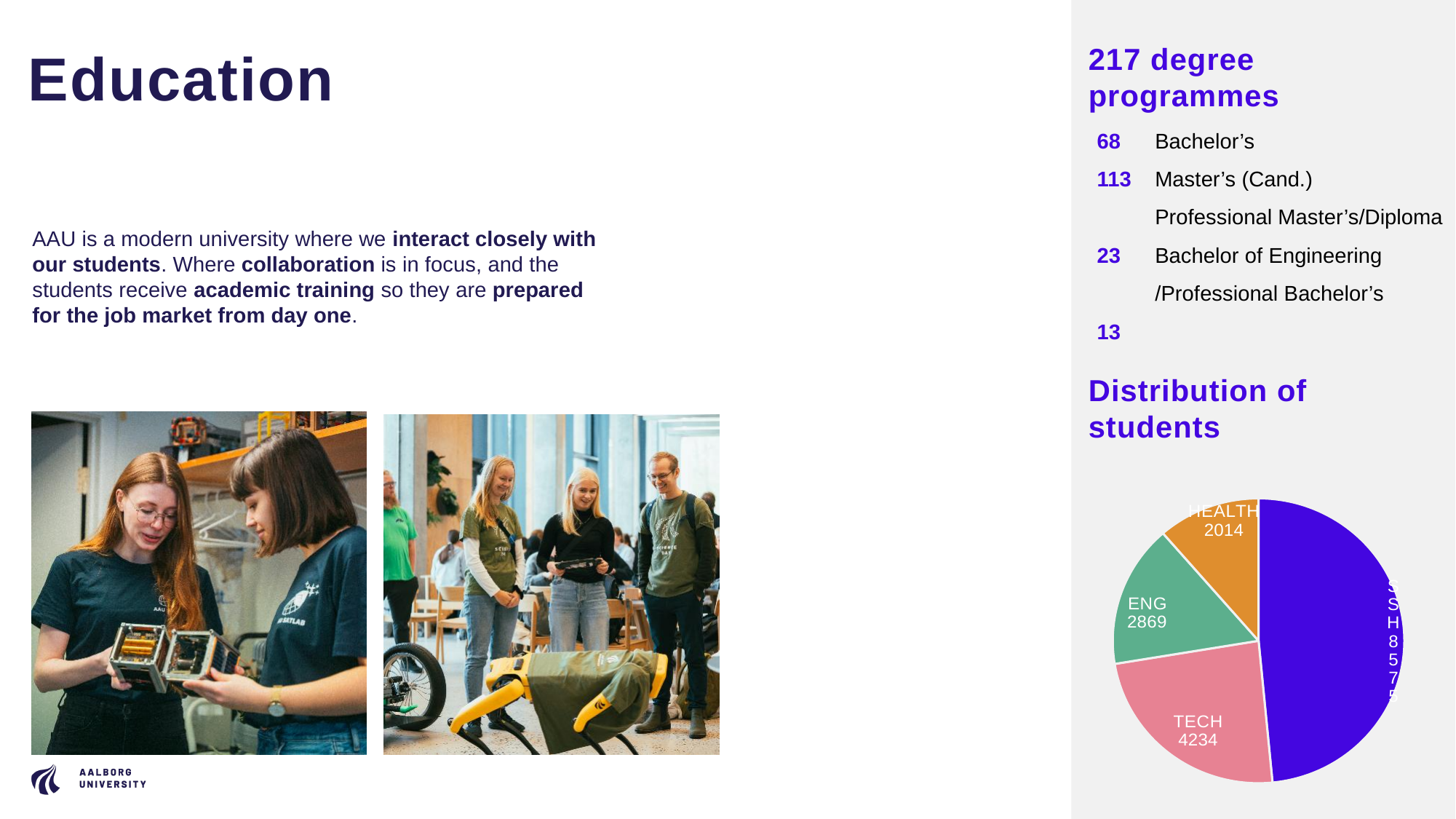
Which slice is the smallest in the "Distribution of students" pie chart? HEALTH Which slice is the largest in the "Distribution of students" pie chart? SSH In the "Distribution of students" pie chart, what is the value for TECH? 4234 What kind of chart is shown under "Distribution of students"? pie chart What colour is the TECH slice in the "Distribution of students" pie chart? pink In the "Distribution of students" pie chart, what is the value for ENG? 2869 In the "Distribution of students" pie chart, which is larger, TECH or ENG? TECH How many slices does the "Distribution of students" pie chart have? 4 In the "Distribution of students" pie chart, what is the difference between TECH and ENG? 1365 In the "Distribution of students" pie chart, what is the difference between ENG and HEALTH? 855 In the "Distribution of students" pie chart, what is the value for HEALTH? 2014 What is the title of the pie chart on the slide? Distribution of students